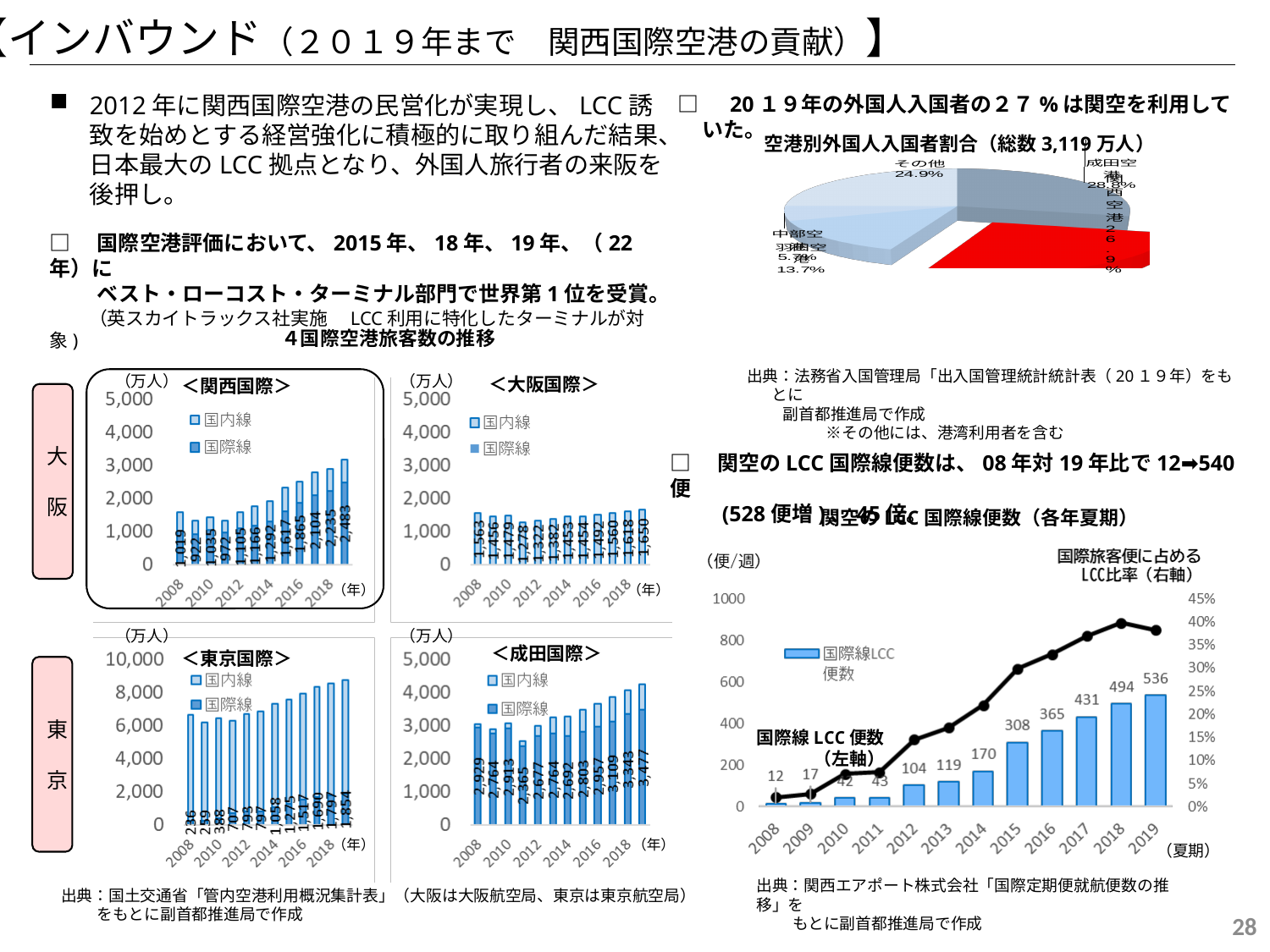
In the ＜成田国際＞ chart, what is the labelled value for 2019? 3,477 In the 関空のLCC国際線便数（各年夏期） chart, how many years are plotted on the x axis? 12 In the 関空のLCC国際線便数（各年夏期） chart, what is the value of 国際線LCC便数 for 2019? 536 In the ＜関西国際＞ chart, what is the labelled value for 2019? 2,483 In the ＜関西国際＞ chart, which year has the lowest labelled value? 2009 In the ＜関西国際＞ chart, how many series does the legend list? 2 In the 関空のLCC国際線便数（各年夏期） chart, by how much did 国際線LCC便数 increase from 2018 to 2019? 42 In the 関空のLCC国際線便数（各年夏期） chart, is the LCC比率 (right axis) for 2019 greater or less than 35%? greater In the 関空のLCC国際線便数（各年夏期） chart, what is the value of 国際線LCC便数 for 2008? 12 In the 空港別外国人入国者割合 pie chart, what share is labelled for その他? 24.9% In the ＜東京国際＞ chart, what is the labelled value for 2008? 236 In the 関空のLCC国際線便数（各年夏期） chart, do the 国際線LCC便数 bars generally rise or fall from 2008 to 2019? rise